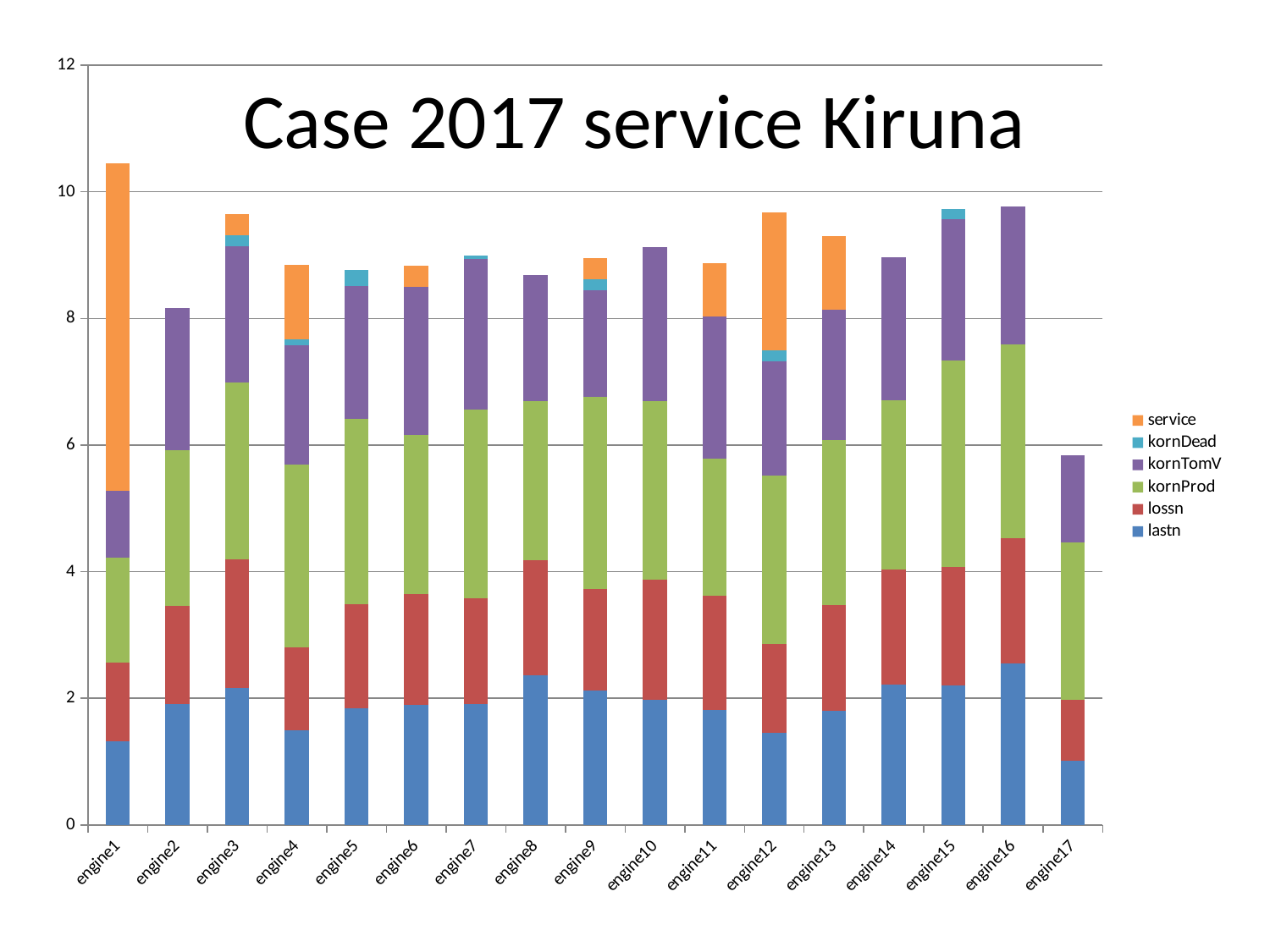
Which has the larger total stacked bar, engine1 or engine2? engine1 How many series does the legend list? 6 Is the total stacked value for engine1 greater or less than 10? greater Is the total stacked value for engine12 greater or less than 9? greater What is the title of the chart? Case 2017 service Kiruna Which series is shown in orange in the legend? service Is the total stacked value for engine16 greater or less than 10? less How many engine categories are shown on the x axis? 17 Which engine has the shortest stacked bar overall? engine17 What kind of chart is shown on the slide? stacked bar chart Which engine has the tallest stacked bar overall? engine1